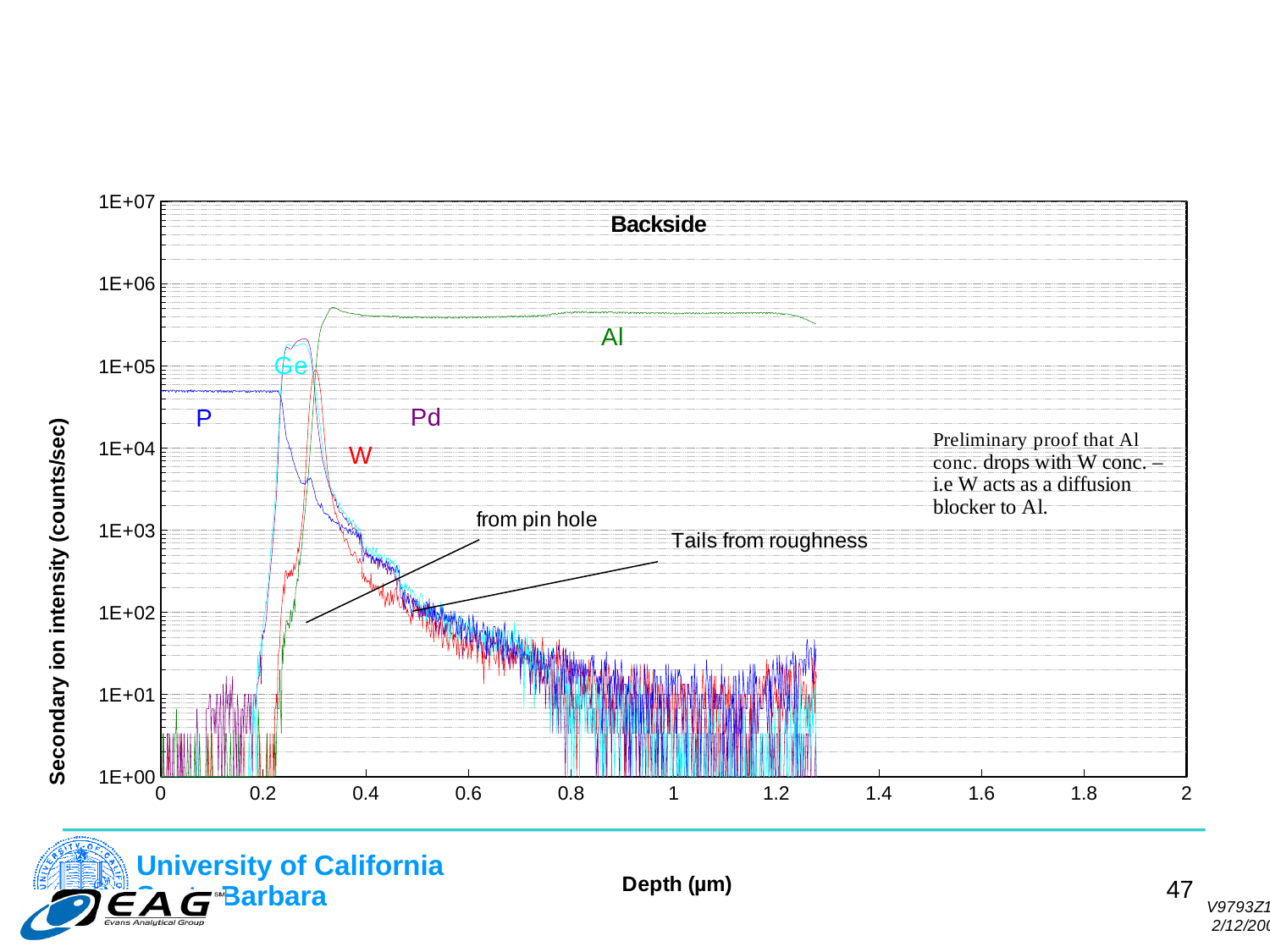
What is the title printed inside the chart? Backside What is the maximum value shown on the x axis? 2 How many element series are labelled on the chart? 5 Does the W intensity rise or fall between depths of 0.4 µm and 0.8 µm? fall Is the P intensity at a depth of 0.1 µm greater or less than 1E+05? less Which series has the highest intensity at a depth of 1 µm? Al Is the Al intensity at a depth of 0.8 µm greater or less than 1E+06? less What is the label of the x axis? Depth (µm) What kind of chart is shown on the slide? line chart At a depth of 0.8 µm, which is larger, the Al intensity or the W intensity? Al Is the P intensity at a depth of 0.1 µm greater or less than 1E+04? greater